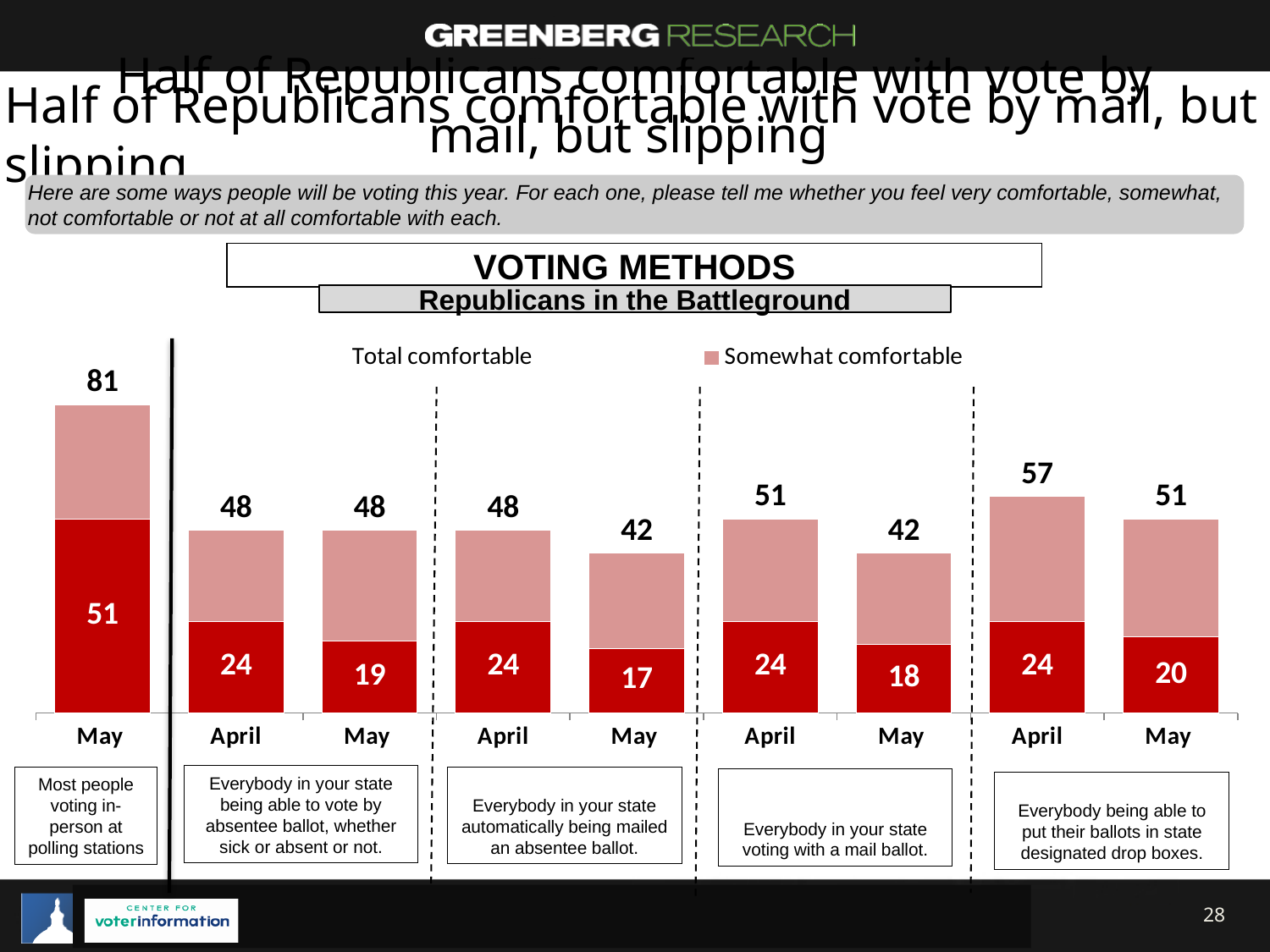
What is the value of the dark red segment for 'Everybody in your state automatically being mailed an absentee ballot' in May? 17 What is the title of the chart? VOTING METHODS What is the difference between the April and May total comfortable values for 'Everybody being able to put their ballots in state designated drop boxes'? 6 What is the total comfortable value for 'Everybody being able to put their ballots in state designated drop boxes' in April? 57 From April to May, does the total comfortable value for 'Everybody being able to put their ballots in state designated drop boxes' rise or fall? Fall What is the total comfortable value for 'Most people voting in-person at polling stations' in May? 81 What is the value of the dark red segment for 'Most people voting in-person at polling stations' in May? 51 What kind of chart is shown on the slide? Stacked bar chart How many bars are shown in the chart? 9 For 'Everybody in your state voting with a mail ballot', which month has the larger total comfortable value, April or May? April What is the total comfortable value for 'Everybody in your state voting with a mail ballot' in May? 42 Which bar has the highest total comfortable value? Most people voting in-person at polling stations (May)